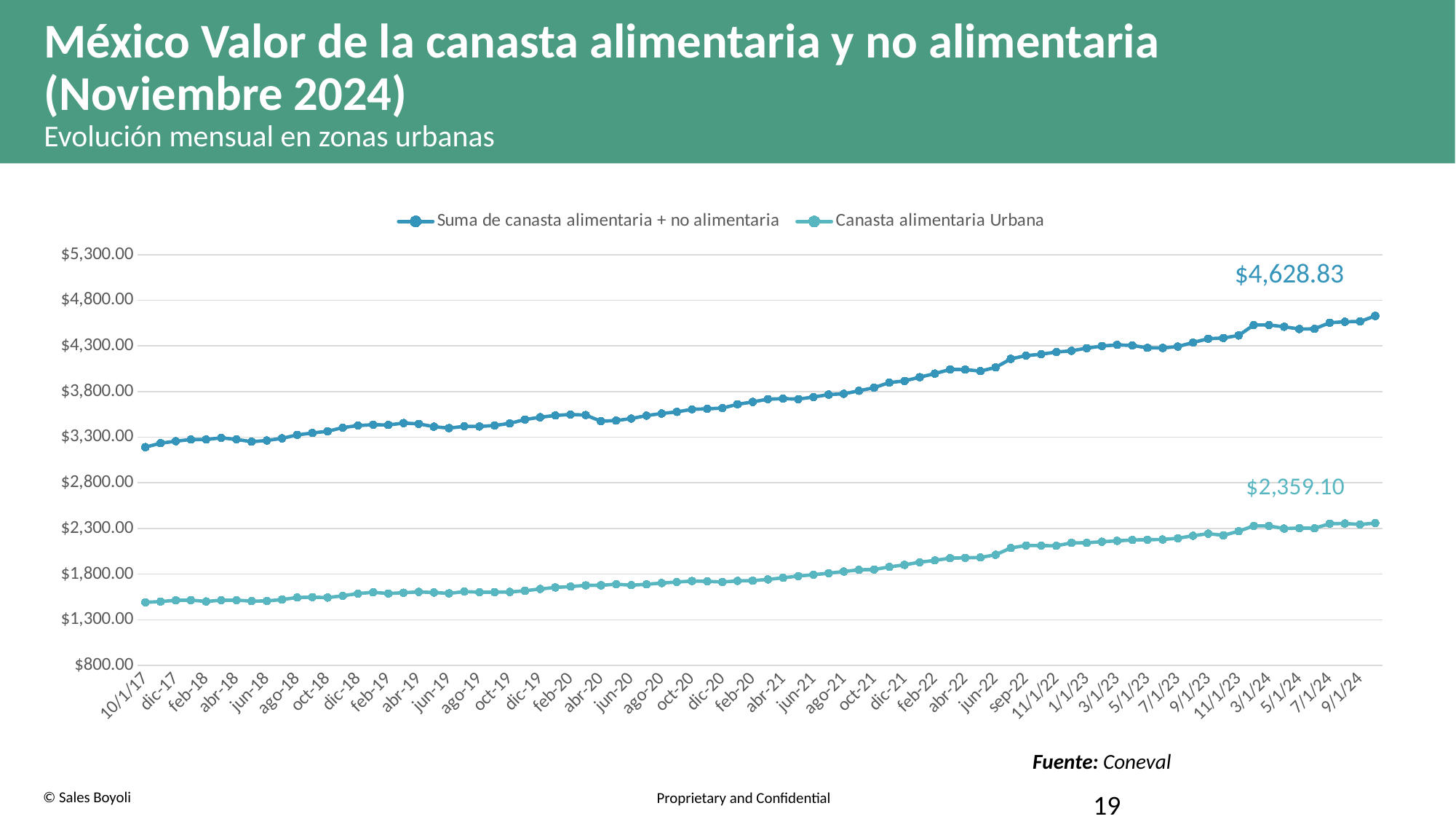
Is the value of 'Canasta alimentaria Urbana' at 10/1/17 greater or less than $1,800.00? less What is the difference between the two labelled final values, $4,628.83 and $2,359.10? $2,269.73 What is the first label on the x axis of the chart? 10/1/17 What is the subtitle shown under the main title of the slide? Evolución mensual en zonas urbanas What kind of chart is shown on the slide? line chart Is the value of 'Suma de canasta alimentaria + no alimentaria' at 9/1/24 greater or less than $4,300.00? greater Which series has the higher value at the end of the chart? Suma de canasta alimentaria + no alimentaria Do the values of the 'Canasta alimentaria Urbana' series rise or fall from 10/1/17 to 9/1/24? rise Is the value of 'Suma de canasta alimentaria + no alimentaria' at 10/1/17 greater or less than $3,300.00? less What is the labelled final value of the 'Canasta alimentaria Urbana' series? $2,359.10 What is the labelled final value of the 'Suma de canasta alimentaria + no alimentaria' series? $4,628.83 How many series does the legend list? 2